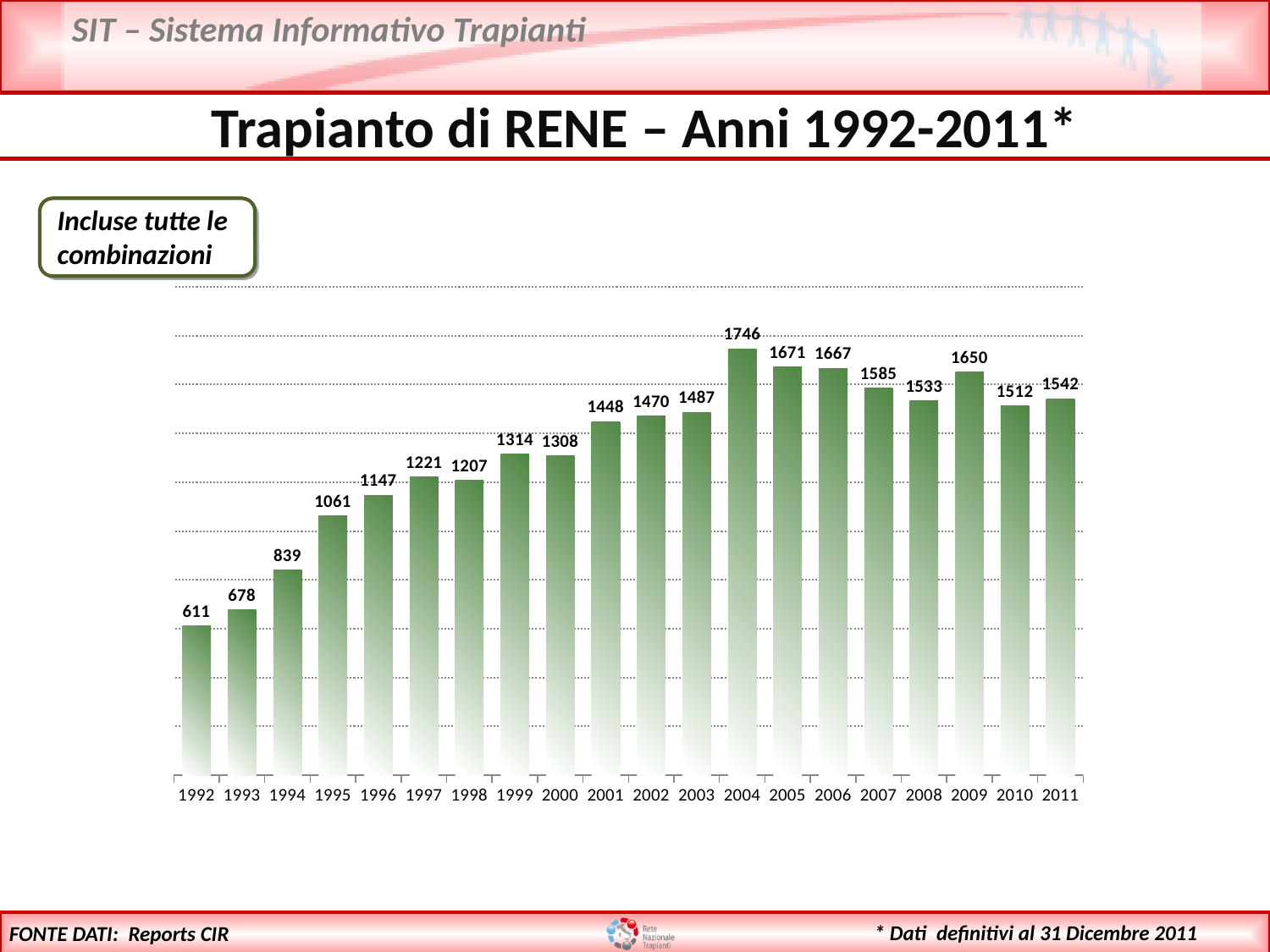
What is the value for 2004? 1746 What is the title of the slide? Trapianto di RENE – Anni 1992-2011* Which is larger, the value for 2009 or the value for 2008? 2009 Which year has the highest value? 2004 What is the value for 1992? 611 Which year has the lowest value? 1992 How many years are shown on the x axis? 20 What kind of chart is this? bar chart What is the value for 2011? 1542 What is the difference between the values for 2004 and 1992? 1135 What is the value for 1999? 1314 What is the difference between the values for 2011 and 2010? 30